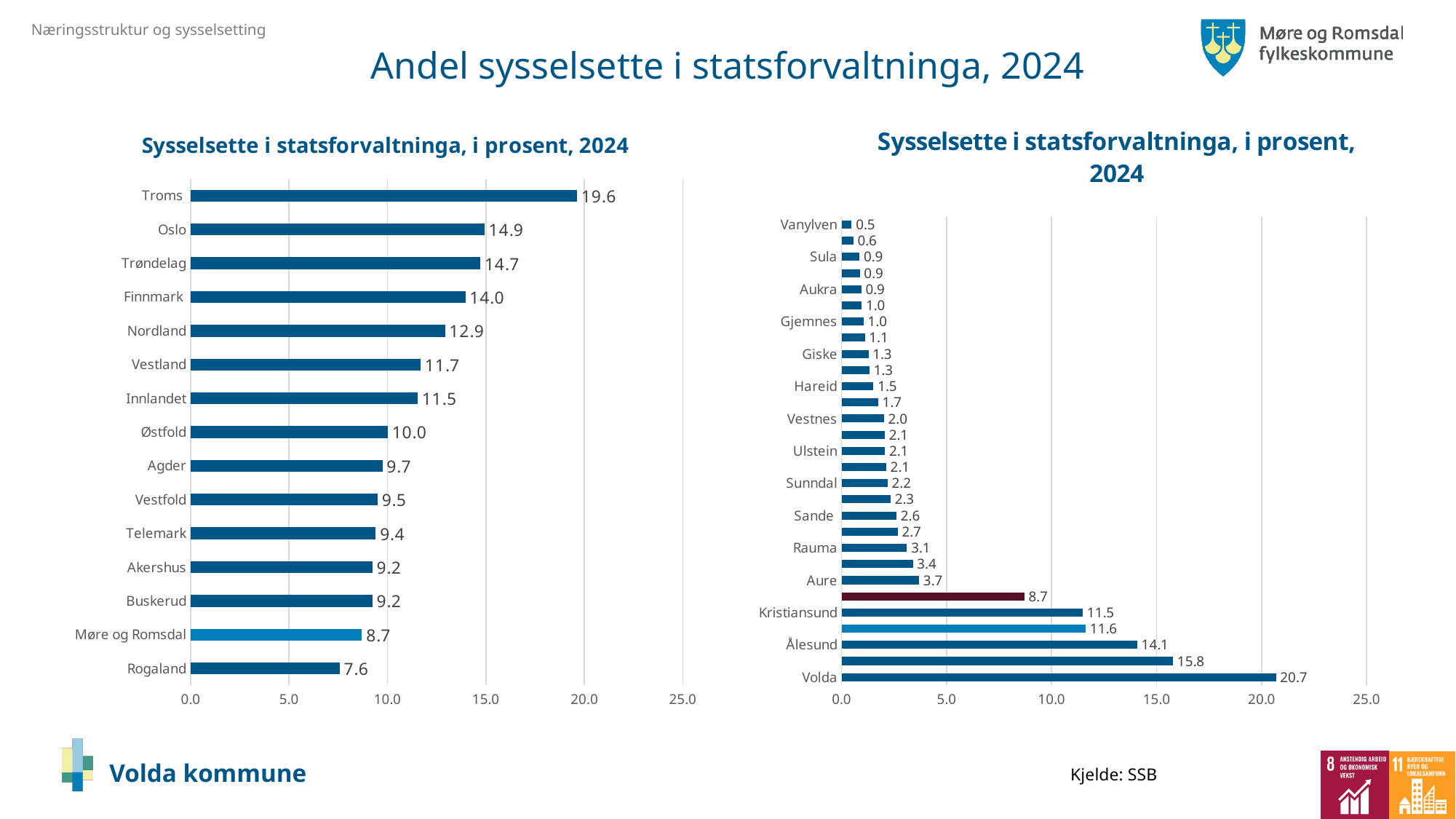
In the left chart, what is the value for Troms? 19.6 In the right chart, what is the difference between the values for Volda and Ålesund? 6.6 In the left chart, which is larger, the value for Nordland or the value for Vestland? Nordland In the left chart, which category has the lowest value? Rogaland In the right chart, which category has the highest value? Volda In the left chart, which category has the highest value? Troms What kind of chart is the left chart? Bar chart How many categories are shown in the left chart? 15 In the right chart, what is the value for Kristiansund? 11.5 In the left chart, what is the value for Møre og Romsdal? 8.7 In the left chart, what is the difference between the values for Oslo and Trøndelag? 0.2 In the right chart, what is the value for Volda? 20.7